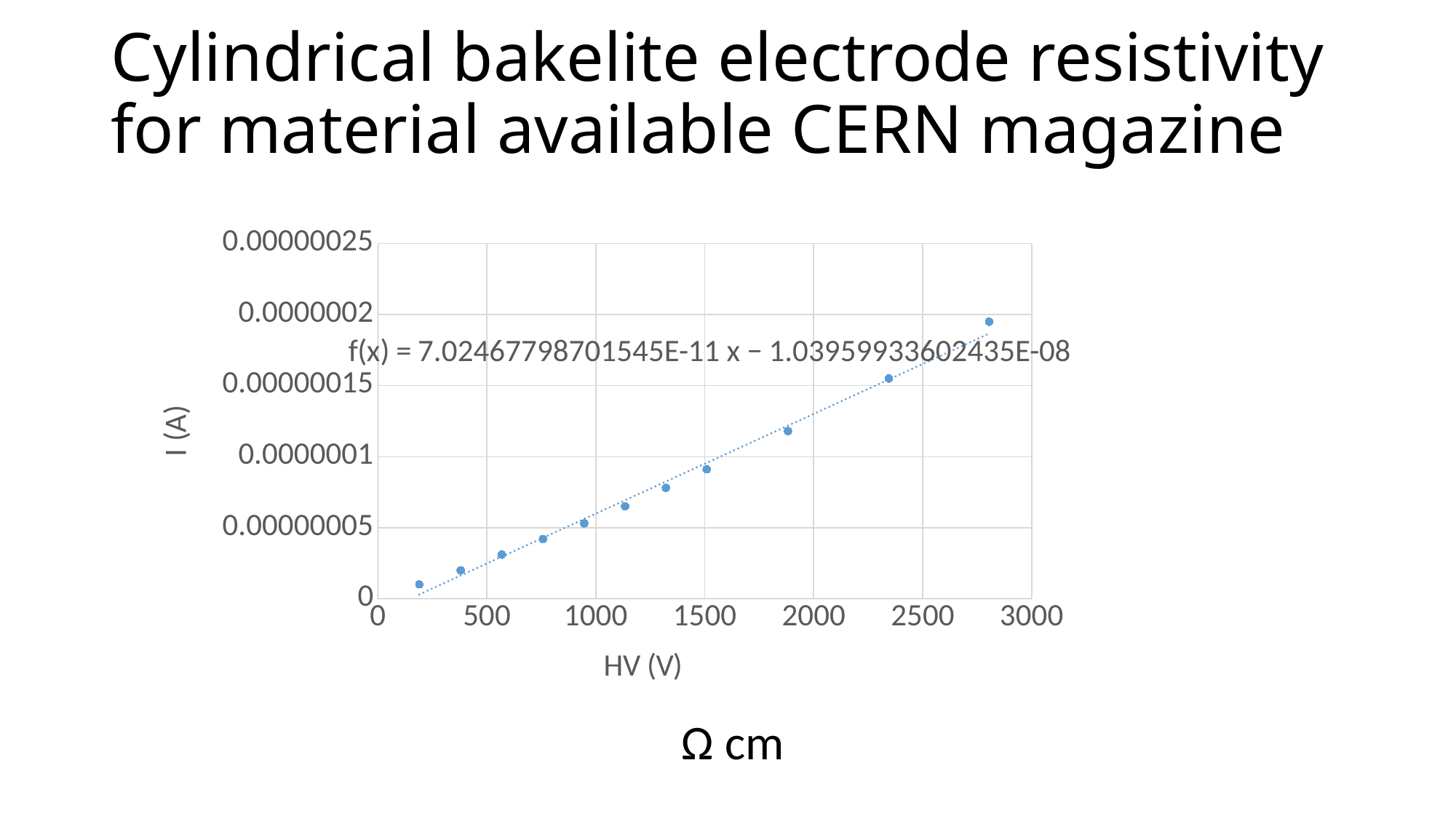
What is the title of the vertical axis of the chart? I (A) Is the current value for the data point at about 1900 V greater or less than 0.0000001? greater Do the plotted current values rise or fall as HV increases along the x axis? rise Is the current value for the data point at about 1500 V greater or less than 0.0000001? less How many data points are plotted on the chart? 11 Does the highest current value occur at the lowest or the highest HV value? highest Does the lowest current value occur at the lowest or the highest HV value? lowest What is the slope (coefficient of x) in the trendline equation shown on the chart? 7.02467798701545E-11 What kind of chart is shown on the slide? scatter chart Is the current value for the rightmost data point (around 2800 V) greater or less than 0.00000015? greater Is the current at about 2300 V larger or smaller than the current at about 1900 V? larger